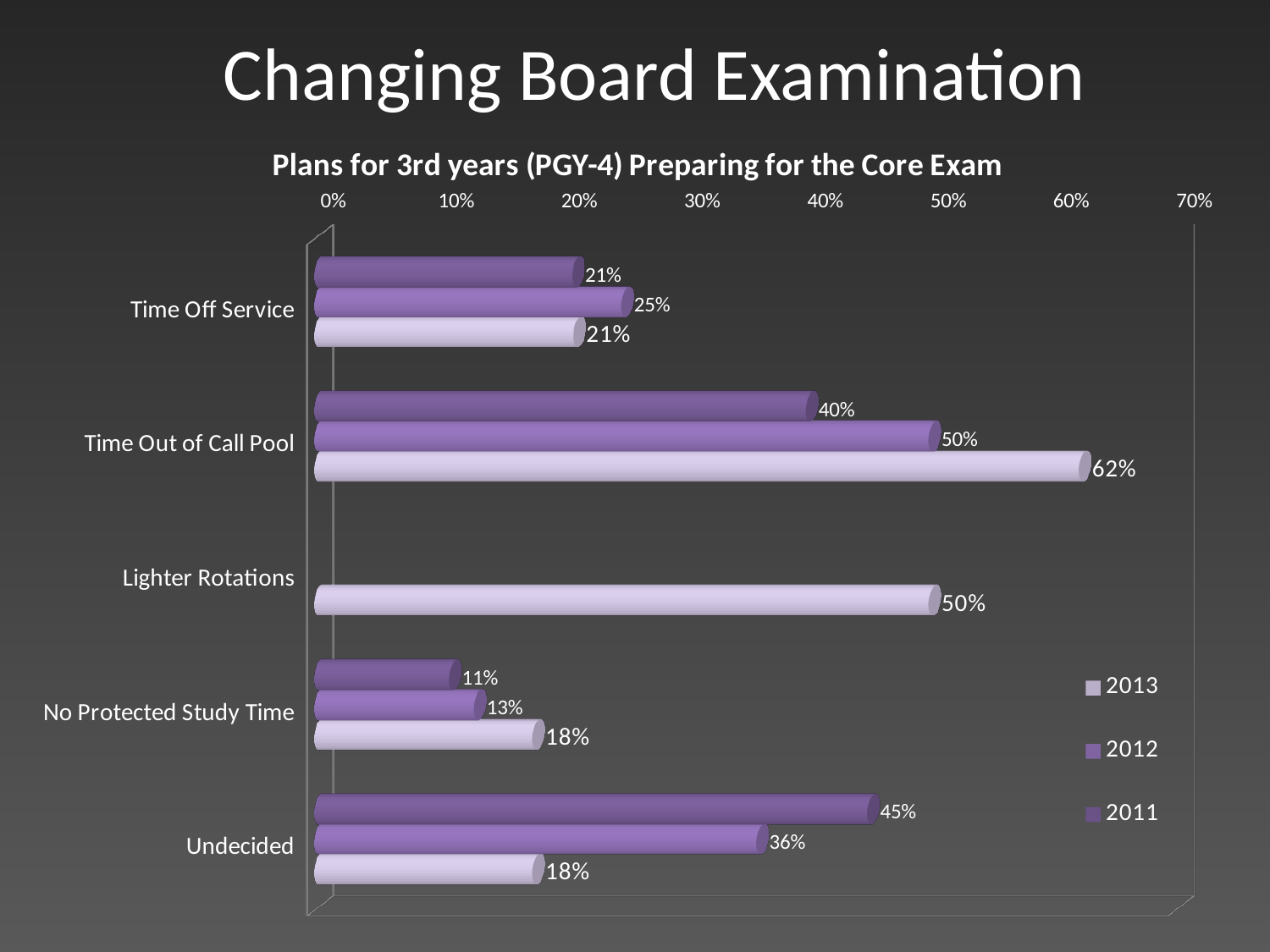
For Time Out of Call Pool, which year has the larger value, 2011 or 2012? 2012 What type of chart is shown on the slide? Bar chart What is the 2013 value for Time Out of Call Pool? 62% Which category has the lowest value in the chart? No Protected Study Time What is the 2011 value for No Protected Study Time? 11% What is the 2012 value for Undecided? 36% How many series does the legend list? 3 How many categories are shown on the vertical axis? 5 What is the difference between the 2011 and 2013 values for Undecided? 27 percentage points What is the 2013 value for Lighter Rotations? 50% Which category has the highest value in the chart? Time Out of Call Pool What is the title of the chart? Plans for 3rd years (PGY-4) Preparing for the Core Exam